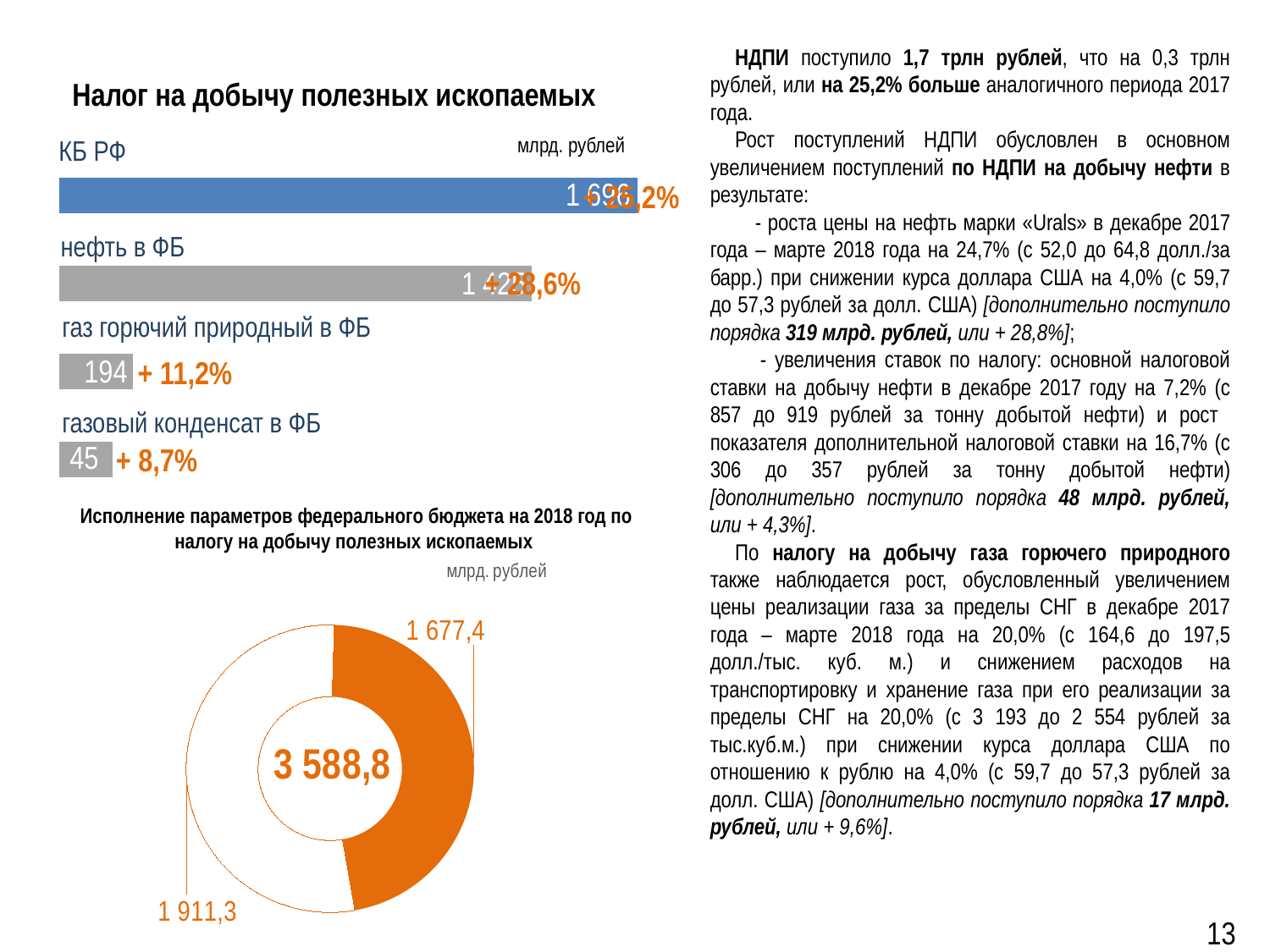
How many categories are shown in the bar chart at the top left? 4 In the chart titled 'Исполнение параметров федерального бюджета на 2018 год по налогу на добычу полезных ископаемых', what value is shown in the centre of the ring? 3 588,8 In the bar chart at the top left, what growth percentage is shown next to 'нефть в ФБ'? + 28,6% What kind of chart is the one titled 'Исполнение параметров федерального бюджета на 2018 год по налогу на добычу полезных ископаемых'? doughnut chart In the bar chart at the top left, what is the difference between the values for 'газ горючий природный в ФБ' and 'газовый конденсат в ФБ'? 149 In the bar chart at the top left, what growth percentage is shown next to 'газ горючий природный в ФБ'? + 11,2% In the chart titled 'Исполнение параметров федерального бюджета на 2018 год по налогу на добычу полезных ископаемых', what value is labelled on the orange segment? 1 677,4 In the bar chart at the top left, what is the value for 'газ горючий природный в ФБ'? 194 In the bar chart at the top left, which category has the highest value? КБ РФ In the bar chart at the top left, what growth percentage is shown next to 'КБ РФ'? + 25,2% In the bar chart at the top left, what is the value for 'газовый конденсат в ФБ'? 45 In the bar chart at the top left, which category has the lowest value? газовый конденсат в ФБ